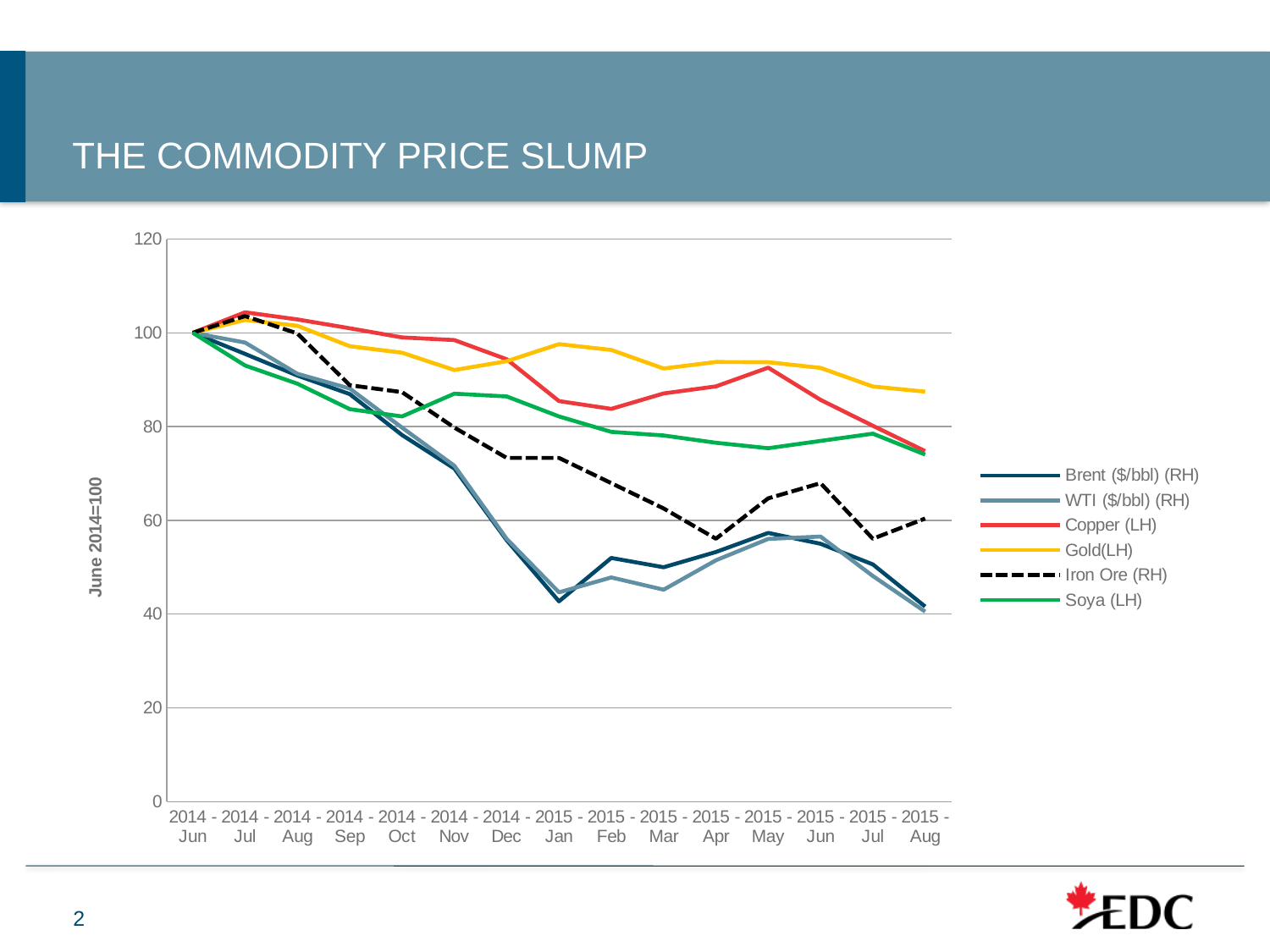
What is the label on the vertical axis? June 2014=100 How many monthly points are plotted along the x axis? 15 Is the value for Brent ($/bbl) (RH) in 2015 - Jan greater or less than 60? less Is the value for Gold (LH) in 2015 - Aug greater or less than 80? greater In 2014 - Dec, which is larger: Soya (LH) or Iron Ore (RH)? Soya (LH) Which series has the highest value in 2015 - Aug? Gold (LH) Which series has the highest value in 2015 - Jan? Gold (LH) Does the Brent ($/bbl) (RH) series rise or fall from 2014 - Jun to 2015 - Jan? fall What kind of chart is shown on the slide? line chart What is the value of Gold (LH) in 2014 - Jun? 100 Is the value for Iron Ore (RH) in 2015 - Apr greater or less than 60? less How many series does the legend list? 6